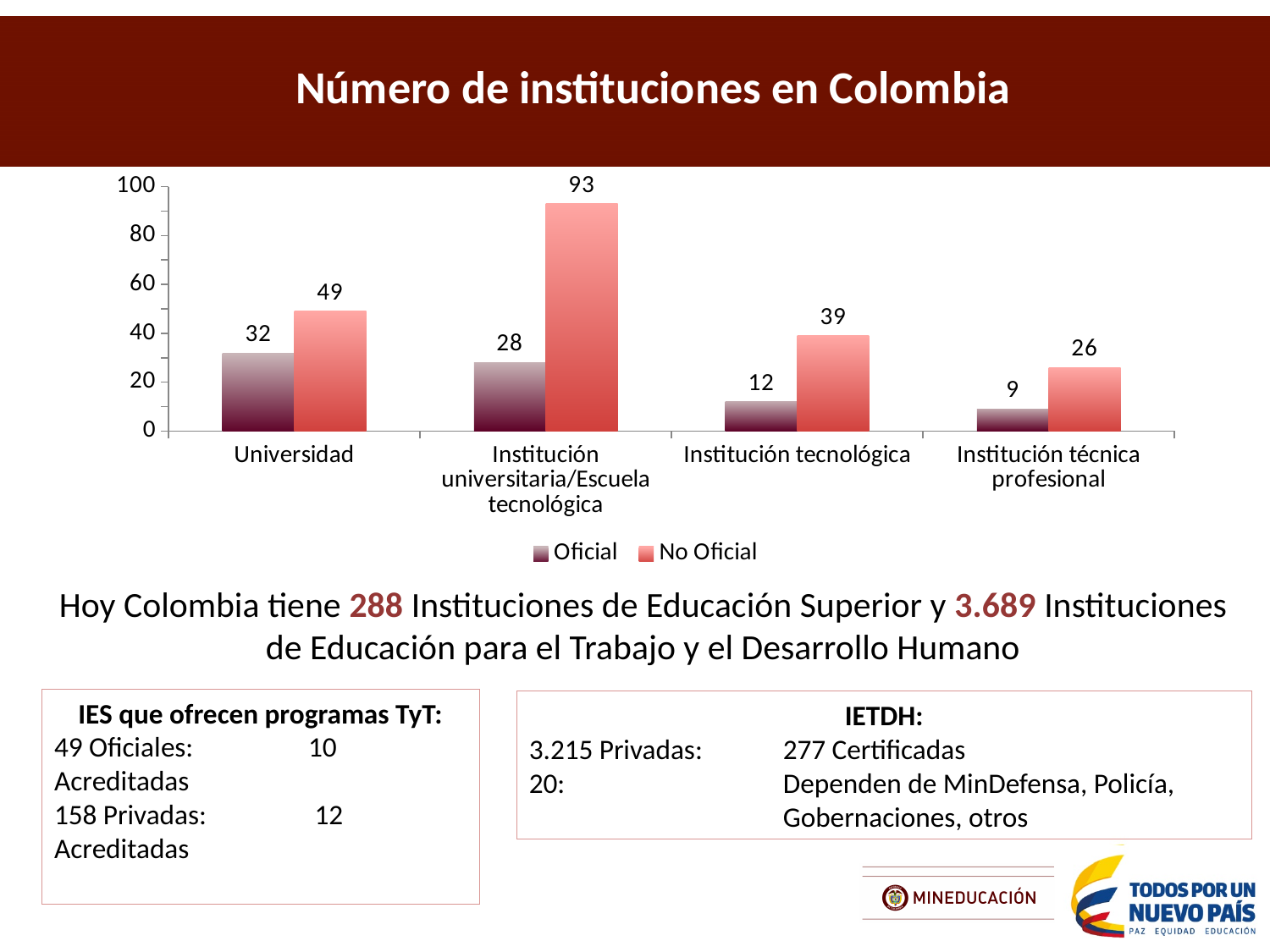
What is the Oficial value for Institución técnica profesional? 9 Which category has the lowest Oficial value? Institución técnica profesional Which is larger, the Oficial value for Universidad or the Oficial value for Institución universitaria/Escuela tecnológica? Oficial value for Universidad How many categories are shown on the x axis? 4 What is the Oficial value for Universidad? 32 What is the title of the chart? Número de instituciones en Colombia What is the No Oficial value for Institución universitaria/Escuela tecnológica? 93 Which category has the highest No Oficial value? Institución universitaria/Escuela tecnológica How many series does the legend list? 2 What is the difference between the No Oficial and Oficial values for Institución tecnológica? 27 What kind of chart is shown on the slide? bar chart Is the No Oficial value for Universidad greater or less than 40? greater